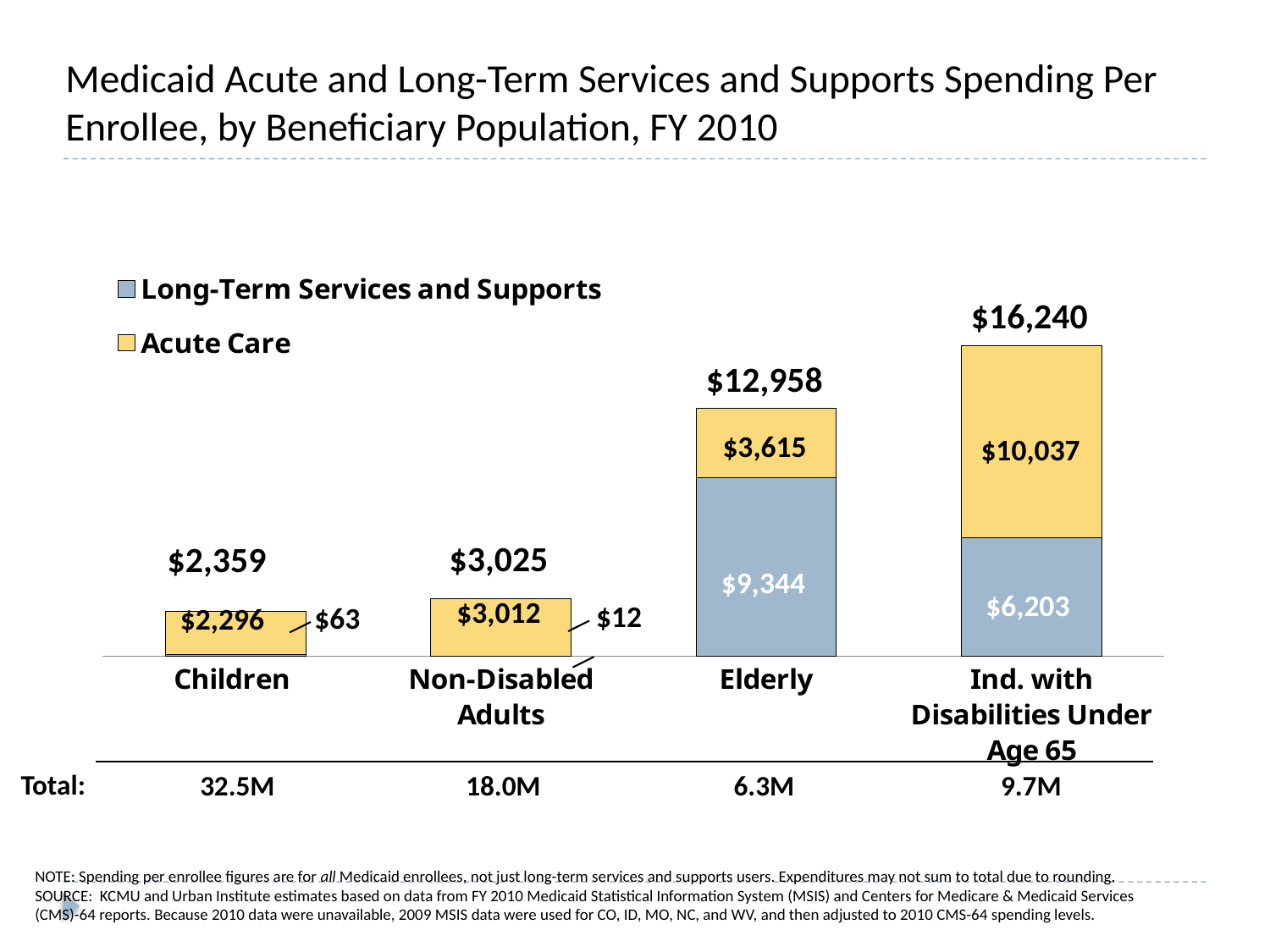
How many series does the legend list? 2 Which beneficiary population has the highest total spending per enrollee? Ind. with Disabilities Under Age 65 How many beneficiary populations are shown on the chart? 4 Which is larger for the Elderly: Acute Care spending or Long-Term Services and Supports spending per enrollee? Long-Term Services and Supports What type of chart is shown on the slide? Stacked bar chart What is the Acute Care spending per enrollee for Ind. with Disabilities Under Age 65? $10,037 Which beneficiary population has the lowest total spending per enrollee? Children What is the Long-Term Services and Supports spending per enrollee for Non-Disabled Adults? $12 What is the total spending per enrollee shown above the Elderly bar? $12,958 What is the Acute Care spending per enrollee for Children? $2,296 What is the difference between the Acute Care spending per enrollee for Ind. with Disabilities Under Age 65 and for the Elderly? $6,422 What is the Long-Term Services and Supports spending per enrollee for the Elderly? $9,344